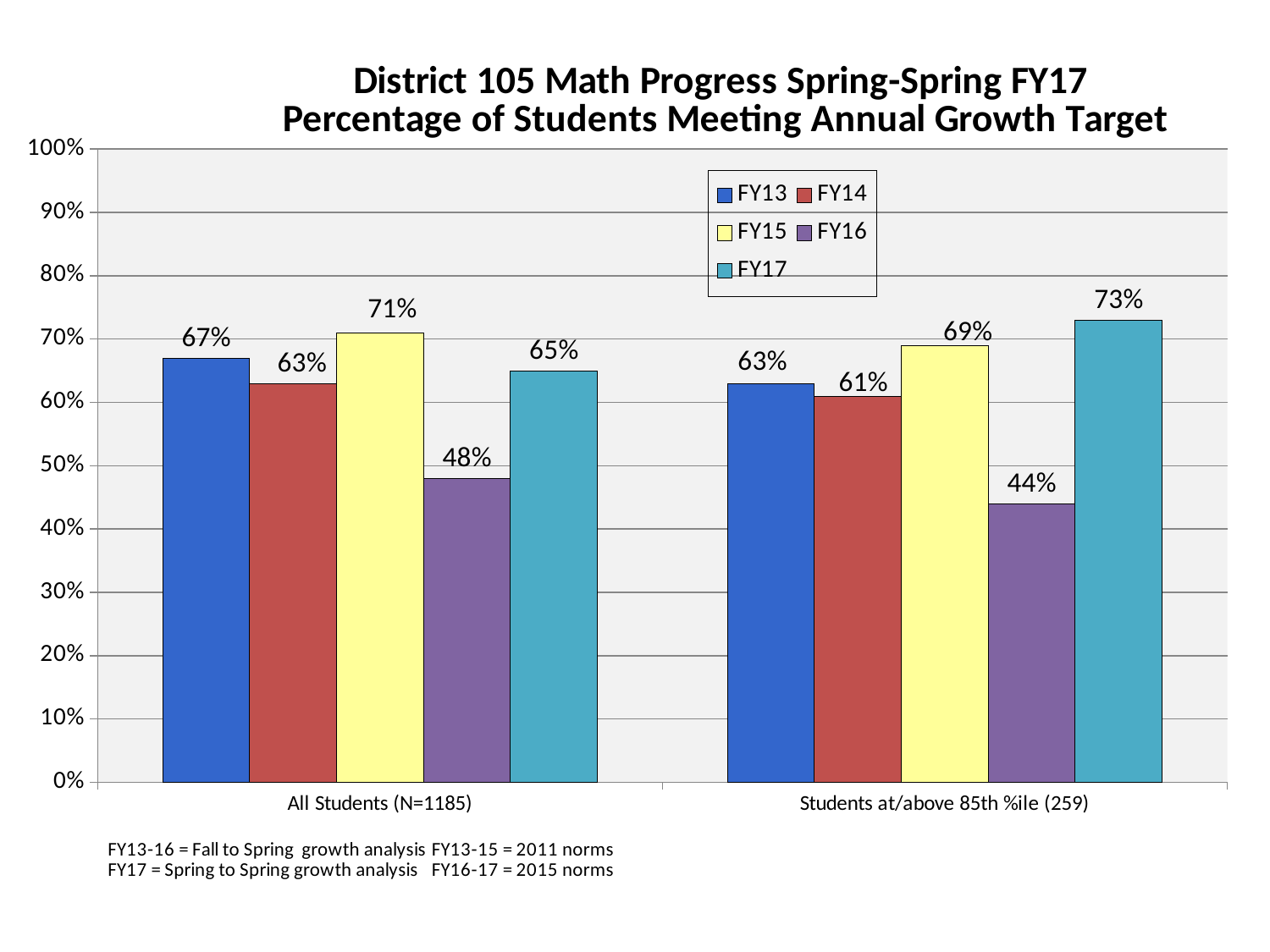
How many series does the legend list? 5 How many categories are shown on the x axis? 2 Which fiscal year has the lowest value for All Students (N=1185)? FY16 Which is larger, the FY13 value for All Students (N=1185) or the FY13 value for Students at/above 85th %ile (259)? All Students (N=1185) Which series is shown in yellow? FY15 What is the difference between the FY17 values for Students at/above 85th %ile (259) and All Students (N=1185)? 8% What is the FY15 value for All Students (N=1185)? 71% What is the FY17 value for All Students (N=1185)? 65% What is the FY16 value for Students at/above 85th %ile (259)? 44% Which fiscal year has the highest value for Students at/above 85th %ile (259)? FY17 What kind of chart is shown on the slide? bar chart Is the FY16 value for All Students (N=1185) greater or less than 50%? less